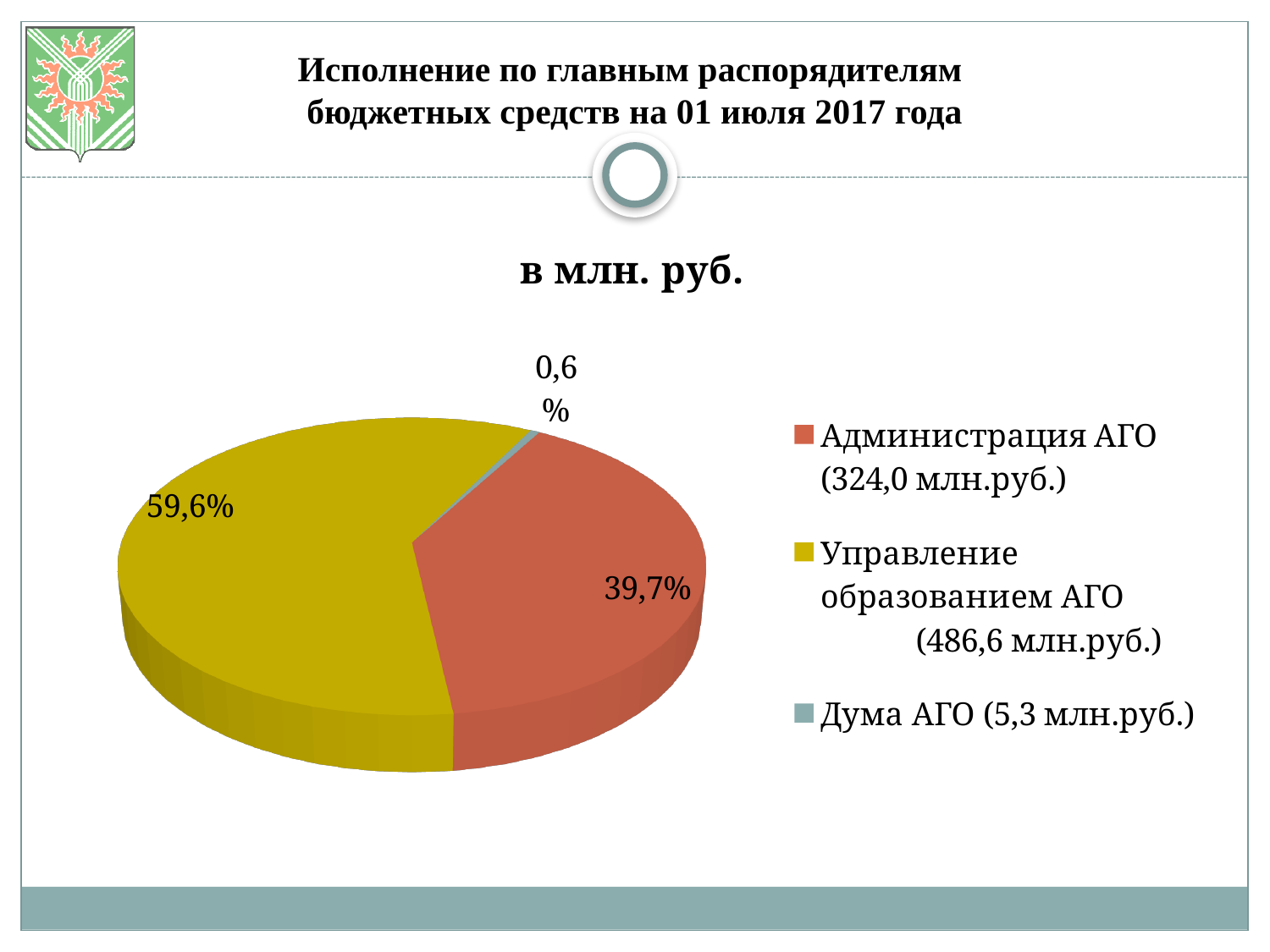
What amount in млн.руб. does the legend give for Дума АГО? 5,3 млн.руб. What share of the pie does Дума АГО hold? 0,6% How many entries does the legend list? 3 What share of the pie does Управление образованием АГО hold? 59,6% What is the difference in percentage points between the shares of Управление образованием АГО and Администрация АГО? 19,9 What kind of chart is shown on the slide? pie chart Which category has the smallest slice of the pie? Дума АГО What share of the pie does Администрация АГО hold? 39,7% What is the title of the chart? в млн. руб. Which category has the largest slice of the pie? Управление образованием АГО How many slices does the pie chart have? 3 Which is larger: the share for Администрация АГО or the share for Управление образованием АГО? Управление образованием АГО